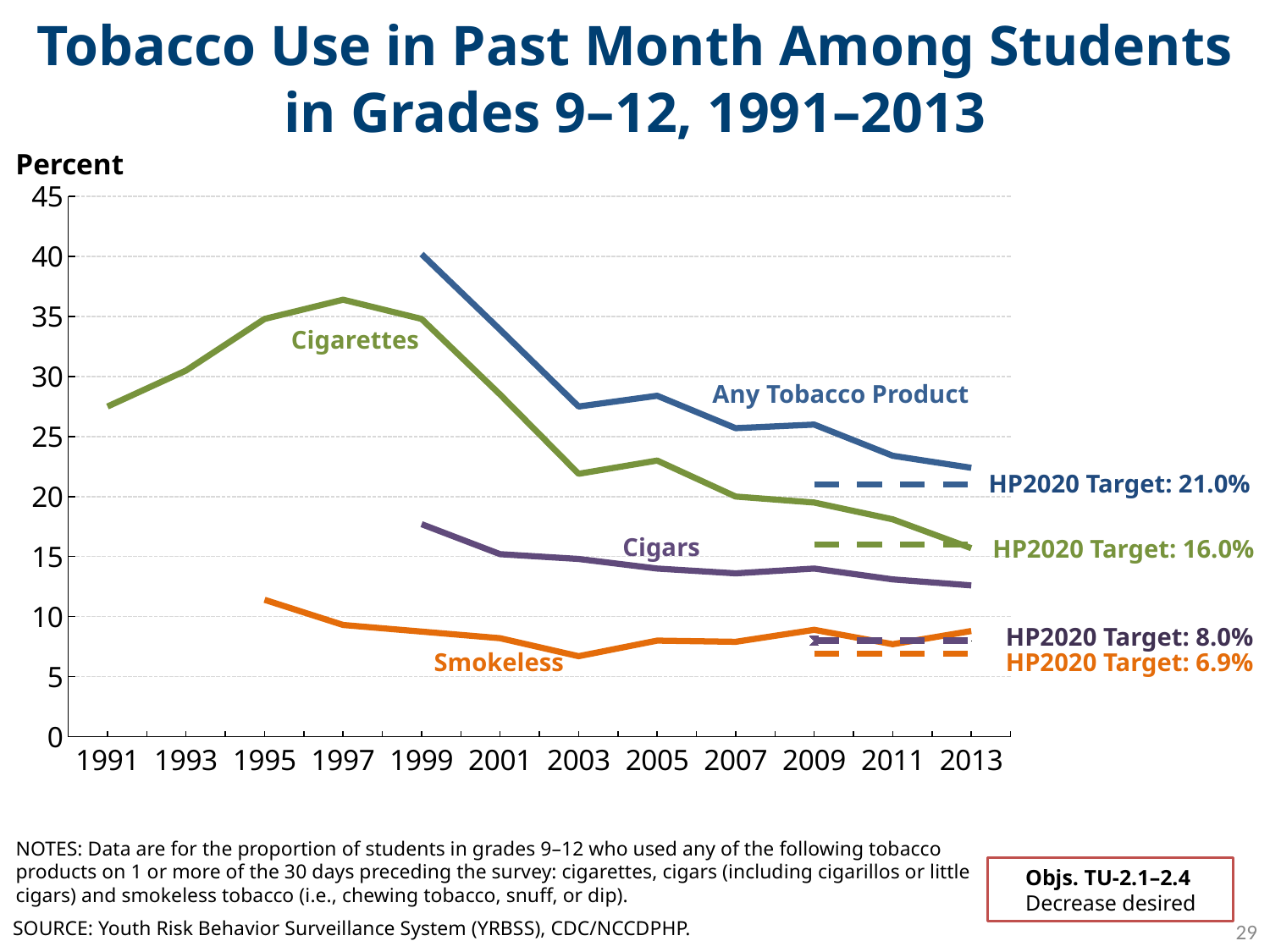
What is the HP2020 Target for Smokeless tobacco? 6.9% What is the HP2020 Target for Cigarettes? 16.0% What is the HP2020 Target for Any Tobacco Product? 21.0% Which series has the lowest value in 2013? Smokeless Is the value for Cigarettes in 1997 greater or less than 35? greater Is the value for Smokeless in 2003 greater or less than 10? less In 2013, which is larger: the value for Cigarettes or the value for Cigars? Cigarettes How many data series are plotted on the chart? 8 Which series has the highest value in 2013? Any Tobacco Product What kind of chart is shown on the slide? line chart Does the Cigarettes line rise or fall from 1999 to 2013? fall Is the value for Any Tobacco Product in 2013 greater or less than 20? greater